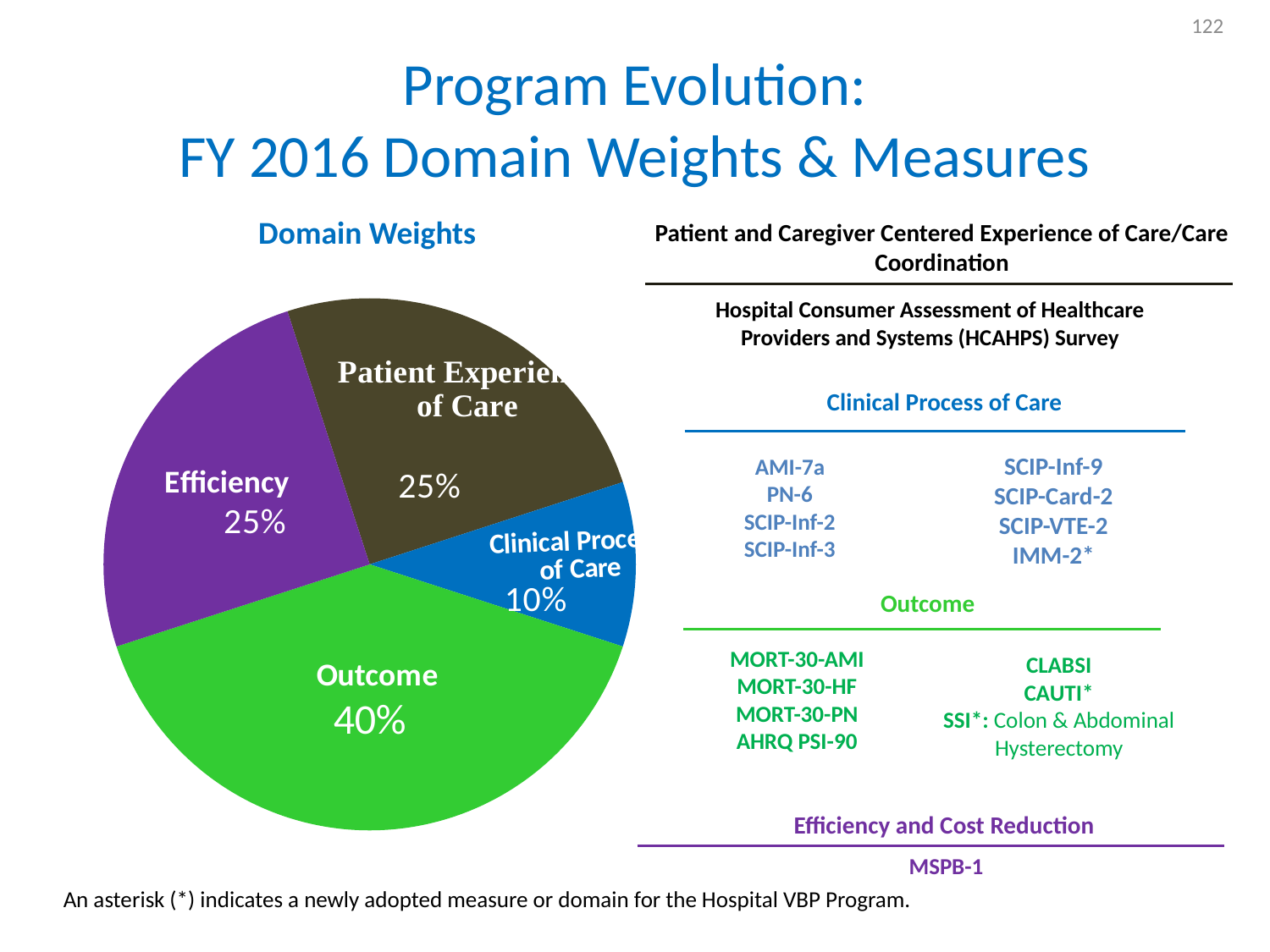
What kind of chart is shown under the title "Domain Weights"? pie chart How many slices does the Domain Weights pie chart have? 4 Which domain has the largest slice in the Domain Weights pie chart? Outcome Which domain has the smallest slice in the Domain Weights pie chart? Clinical Process of Care In the Domain Weights pie chart, which is larger: the Outcome slice or the Efficiency slice? Outcome What is the weight shown for the Outcome domain in the Domain Weights pie chart? 40% What is the weight shown for the Efficiency domain in the Domain Weights pie chart? 25% In the Domain Weights pie chart, what is the difference between the Outcome weight and the Clinical Process of Care weight? 30% What is the weight shown for the Patient Experience of Care domain in the Domain Weights pie chart? 25% What is the weight shown for the Clinical Process of Care domain in the Domain Weights pie chart? 10% What colour is the Outcome slice in the Domain Weights pie chart? green In the Domain Weights pie chart, what share of the pie does the Outcome slice represent? 40%